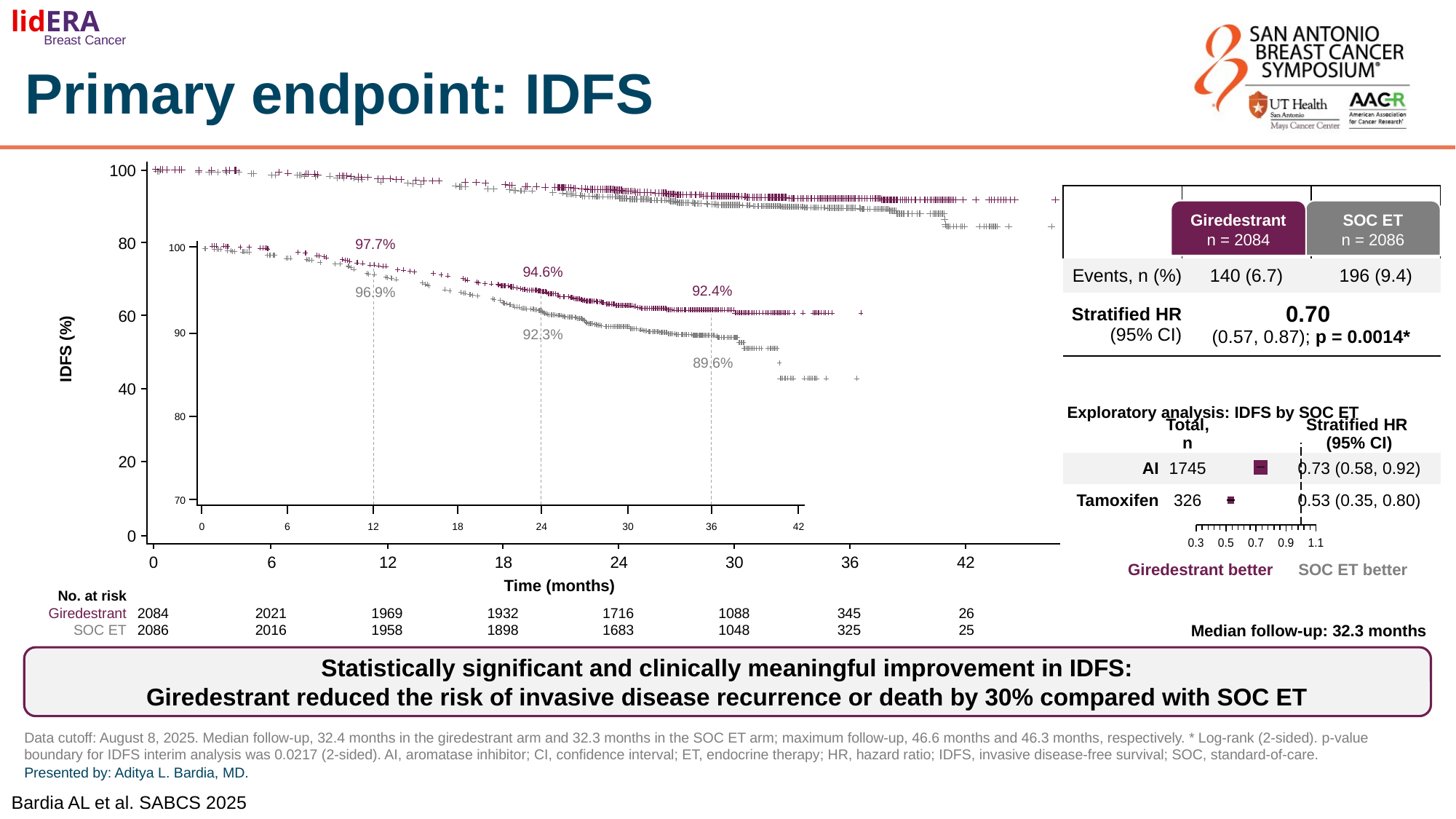
In the exploratory forest plot (IDFS by SOC ET), what is the stratified HR (95% CI) for the tamoxifen subgroup? 0.53 (0.35, 0.80) In the Kaplan-Meier plot, what is the difference between the giredestrant and SOC ET IDFS rates at 36 months? 2.8 percentage points In the number-at-risk table below the Kaplan-Meier plot, how many SOC ET patients were at risk at 18 months? 1898 In the Kaplan-Meier plot, what is the IDFS rate for SOC ET at 24 months? 92.3% In the Kaplan-Meier plot, do the IDFS curves rise or fall as time in months increases? Fall What kind of chart is the main plot on the left of the slide? Line chart (Kaplan-Meier curve) In the number-at-risk table below the Kaplan-Meier plot, how many giredestrant patients were at risk at 30 months? 1088 What is the label on the y-axis of the Kaplan-Meier plot? IDFS (%) In the Kaplan-Meier plot, which arm has the higher IDFS rate at 24 months, giredestrant or SOC ET? Giredestrant In the Kaplan-Meier plot, what is the difference between the giredestrant and SOC ET IDFS rates at 12 months? 0.8 percentage points In the Kaplan-Meier plot, what is the IDFS rate for giredestrant at 36 months? 92.4% In the exploratory forest plot (IDFS by SOC ET), what is the total n for the AI subgroup? 1745